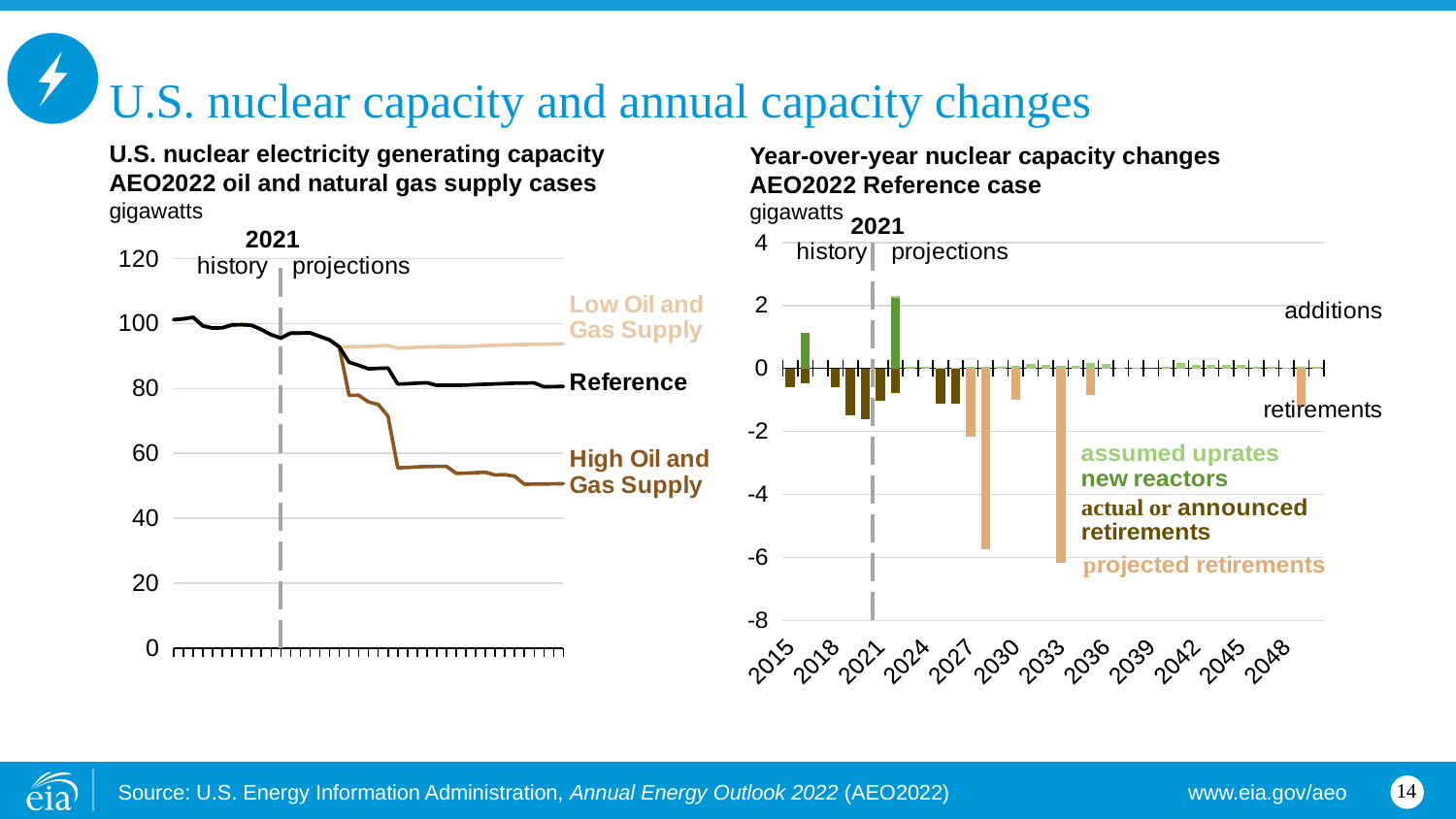
What kind of chart is the right chart, 'Year-over-year nuclear capacity changes'? bar chart In the left chart, is the High Oil and Gas Supply value at the end of the projection period greater or less than 60? less In the left chart, does the Reference series rise or fall over the projection period? fall What kind of chart is the left chart, 'U.S. nuclear electricity generating capacity'? line chart How many series are plotted in the left chart, 'U.S. nuclear electricity generating capacity'? 3 In the left chart, is the Low Oil and Gas Supply value at the end of the projection period greater or less than 80? greater What unit is used on the y axis of the right chart, 'Year-over-year nuclear capacity changes'? gigawatts How many series does the legend of the right chart, 'Year-over-year nuclear capacity changes', list? 4 In the right chart, which year does the dashed vertical line separating history from projections mark? 2021 In the right chart, is the value of the largest projected retirements bar greater or less than -4? less In the left chart, which series has the highest capacity at the end of the projection period? Low Oil and Gas Supply In the left chart, which series has the lowest capacity at the end of the projection period? High Oil and Gas Supply